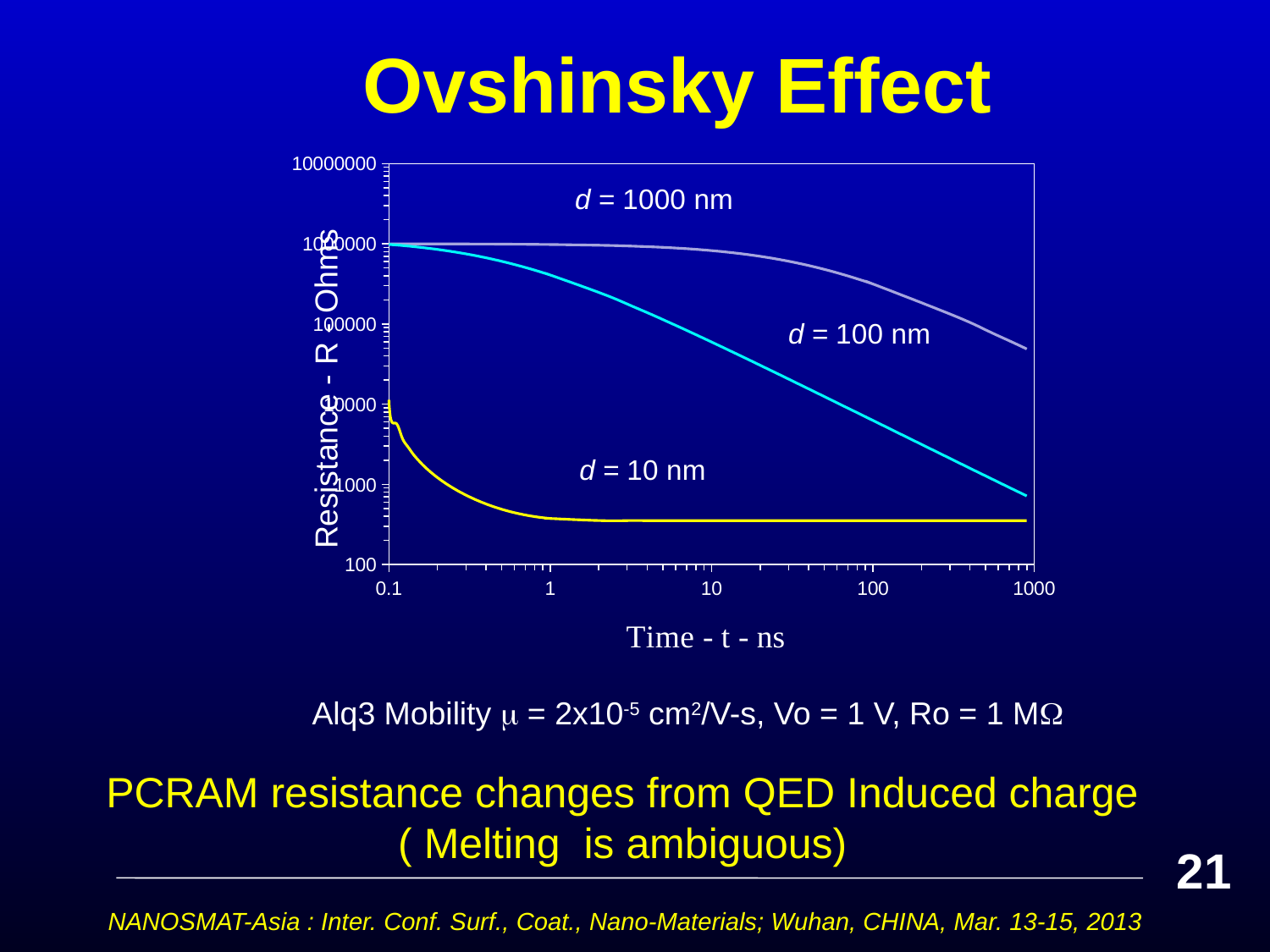
What kind of chart is shown on the slide? line chart How many curves are plotted on the chart? 3 Does the resistance for d = 1000 nm rise or fall as time increases from 10 ns to 1000 ns? fall Does the resistance for d = 100 nm rise or fall as time increases? fall What is the label of the y axis of the chart? Resistance - R - Ohms At t = 100 ns, which curve has the higher resistance, d = 100 nm or d = 1000 nm? d = 1000 nm What is the label of the x axis of the chart? Time - t - ns Is the resistance for d = 1000 nm at t = 1000 ns greater or less than 10000 Ohms? greater At t = 10 ns, which curve has the higher resistance, d = 1000 nm or d = 10 nm? d = 1000 nm Is the resistance for d = 1000 nm at t = 1 ns greater or less than 100000 Ohms? greater Is the resistance for d = 10 nm at t = 1000 ns greater or less than 1000 Ohms? less